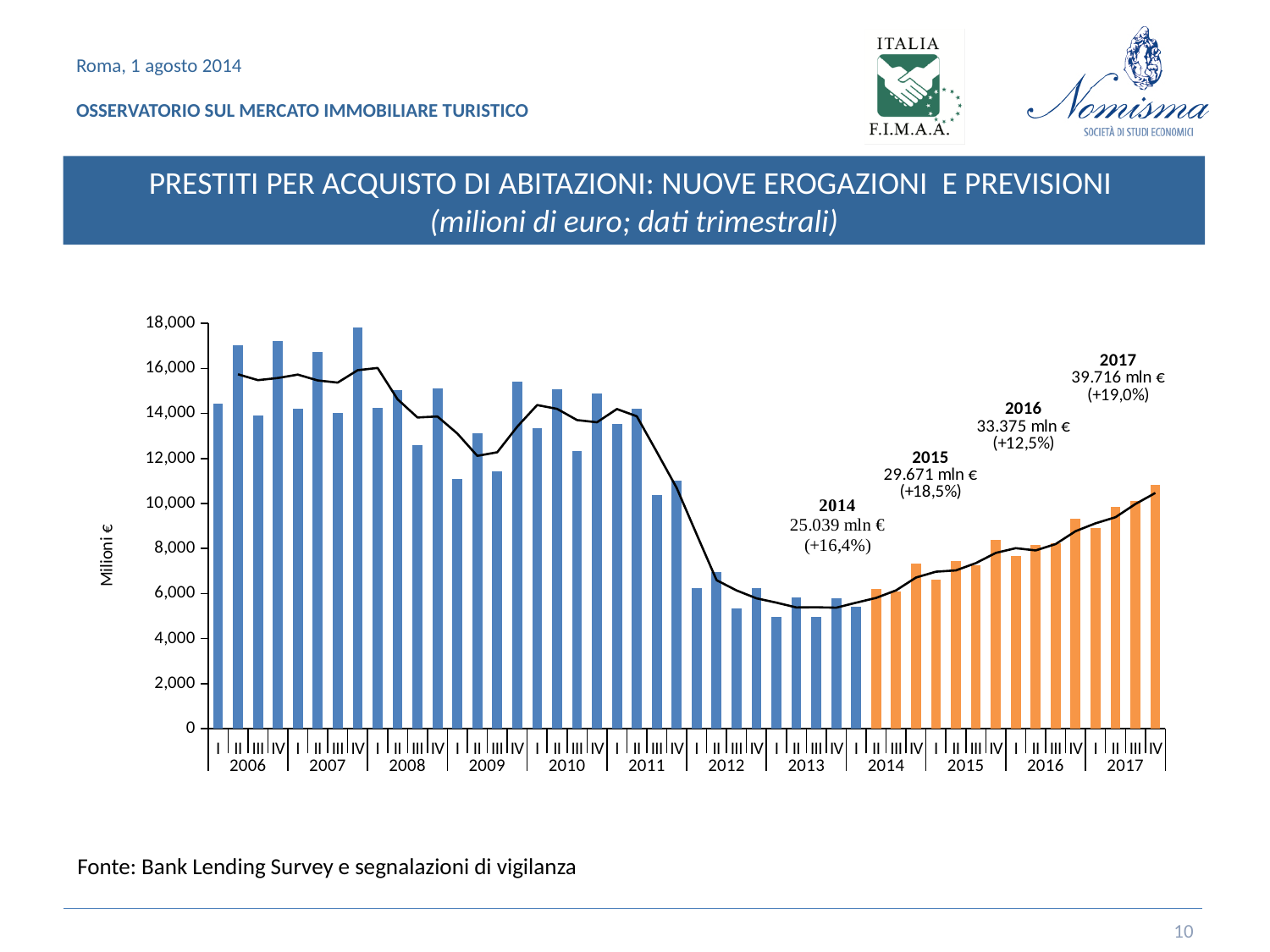
What kind of chart is shown on the slide? bar chart What percentage change is annotated for 2017? +19,0% Is the value for quarter IV of 2007 greater or less than 16,000? greater What is the difference between the annotated annual values for 2017 and 2016? 6.341 mln € What annual value is annotated for 2015? 29.671 mln € Is the value for quarter I of 2013 greater or less than 6,000? less How many years are shown on the x axis? 12 What annual value is annotated for 2017? 39.716 mln € What annual value is annotated for 2016? 33.375 mln € What annual value is annotated for 2014? 25.039 mln € Which annotated year has the higher annual value, 2014 or 2015? 2015 Do the bar values rise or fall from 2014 to 2017? rise